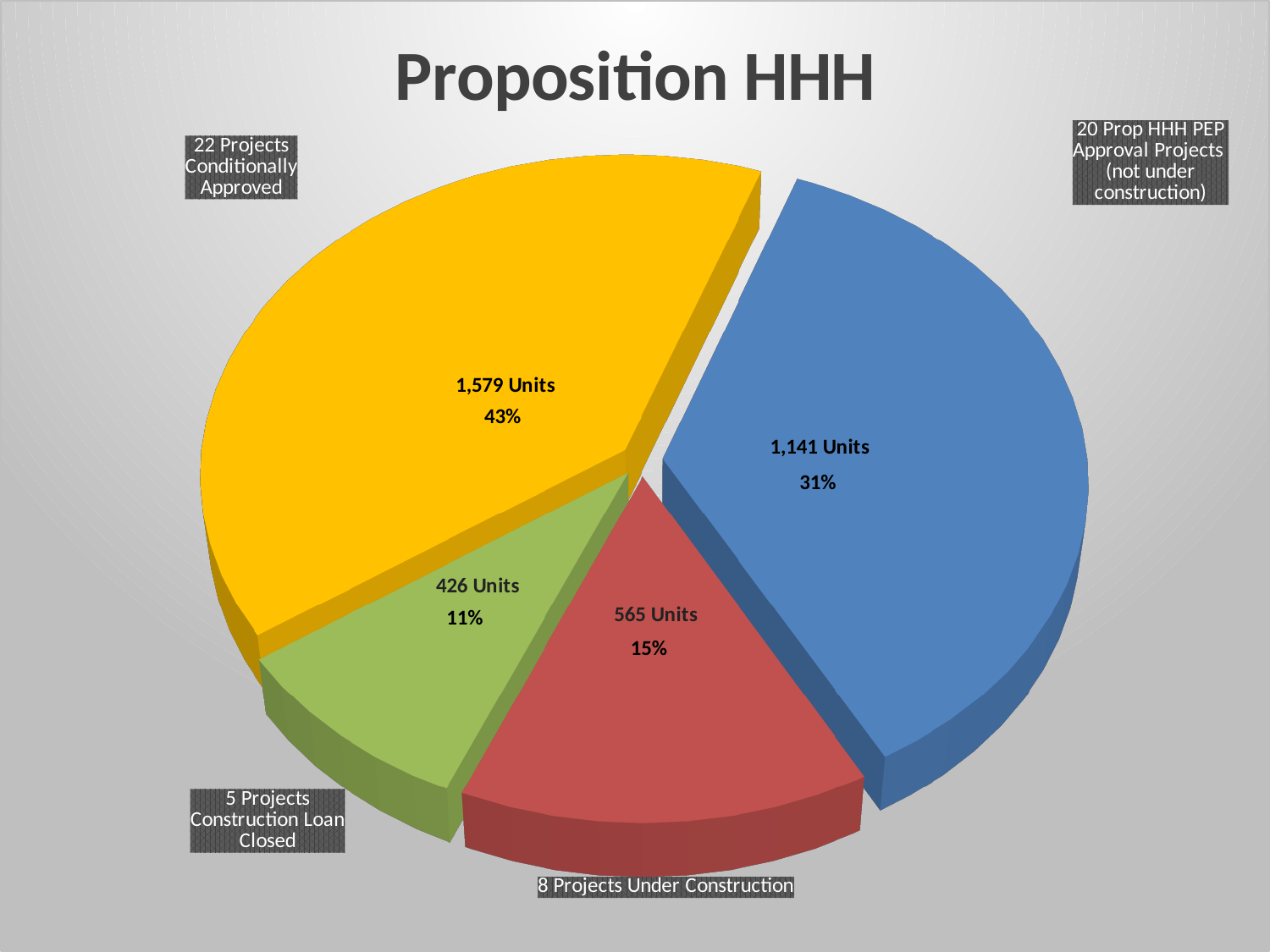
How many units are shown for the 8 Projects Under Construction slice? 565 Units How many units are shown for the 22 Projects Conditionally Approved slice? 1,579 Units What percentage share does the 5 Projects Construction Loan Closed slice have? 11% What is the title of the chart? Proposition HHH What percentage share does the 20 Prop HHH PEP Approval Projects (not under construction) slice have? 31% What is the difference in units between the 22 Projects Conditionally Approved slice and the 20 Prop HHH PEP Approval Projects (not under construction) slice? 438 Units Which has more units: 8 Projects Under Construction or 5 Projects Construction Loan Closed? 8 Projects Under Construction Which slice has the largest number of units? 22 Projects Conditionally Approved How many units are shown for the 5 Projects Construction Loan Closed slice? 426 Units What type of chart is shown on the slide? Pie chart How many slices does the pie chart have? 4 Which slice has the smallest number of units? 5 Projects Construction Loan Closed